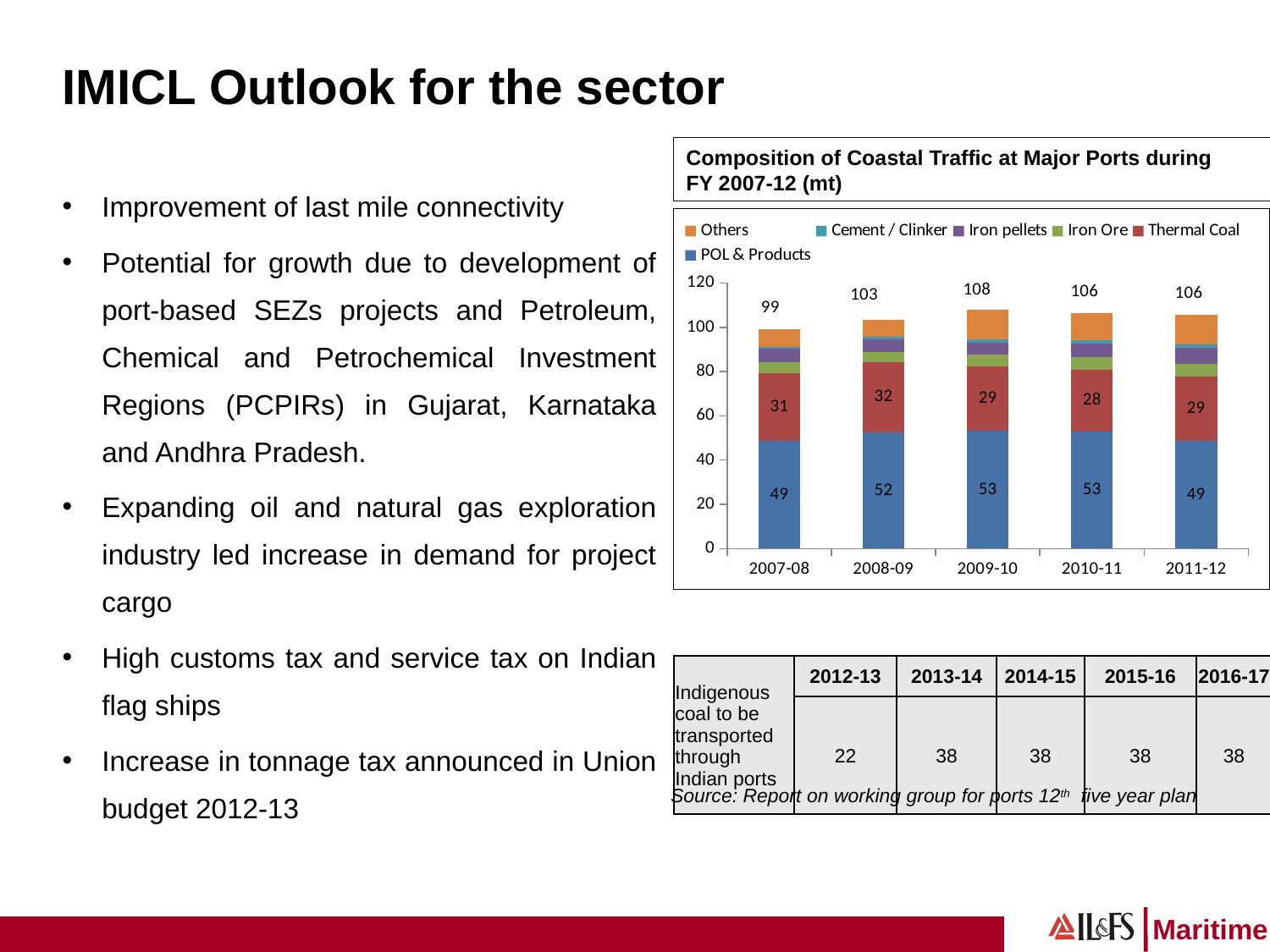
What is the difference between the Thermal Coal values for 2007-08 and 2010-11? 3 How many years are shown on the x axis? 5 What is the value for POL & Products in 2008-09? 52 Which year has the lowest total coastal traffic? 2007-08 What is the title of the chart? Composition of Coastal Traffic at Major Ports during FY 2007-12 (mt) Which year has the highest total coastal traffic? 2009-10 What is the value for Thermal Coal in 2010-11? 28 What kind of chart is shown? Stacked bar chart How many series does the legend list? 6 What is the total of the stacked bar for 2009-10? 108 Which is larger, the POL & Products value for 2009-10 or for 2011-12? 2009-10 Is the total for 2007-08 greater or less than 100? less